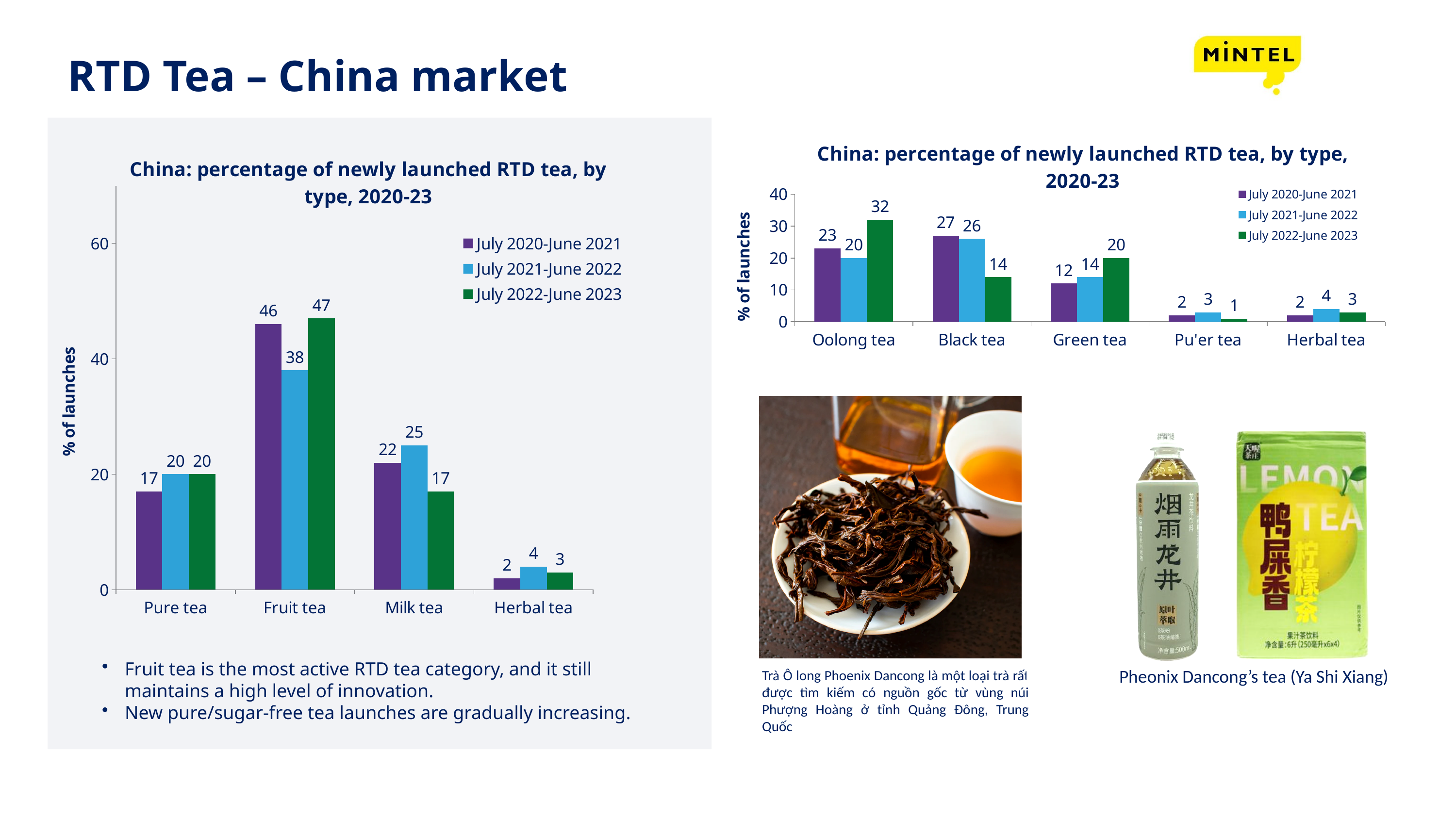
In the left chart, what is the value for Fruit tea in July 2021-June 2022? 38 In the left chart, which category has the highest value for July 2022-June 2023? Fruit tea In the right chart, which category has the lowest value for July 2022-June 2023? Pu'er tea In the right chart, how does the value for Green tea change from July 2020-June 2021 to July 2022-June 2023? It rises In the right chart, what is the value for Black tea in July 2020-June 2021? 27 In the left chart, what is the difference between the Fruit tea values for July 2022-June 2023 and July 2021-June 2022? 9 In the left chart, how many categories are shown on the x axis? 4 In the right chart, is the value for Green tea in July 2020-June 2021 larger or smaller than the value for Oolong tea in July 2020-June 2021? smaller In the right chart, what is the value for Oolong tea in July 2022-June 2023? 32 In the left chart, which category has the lowest value for July 2020-June 2021? Herbal tea How many series does the legend of the right chart list? 3 In the left chart, what is the value for Milk tea in July 2022-June 2023? 17